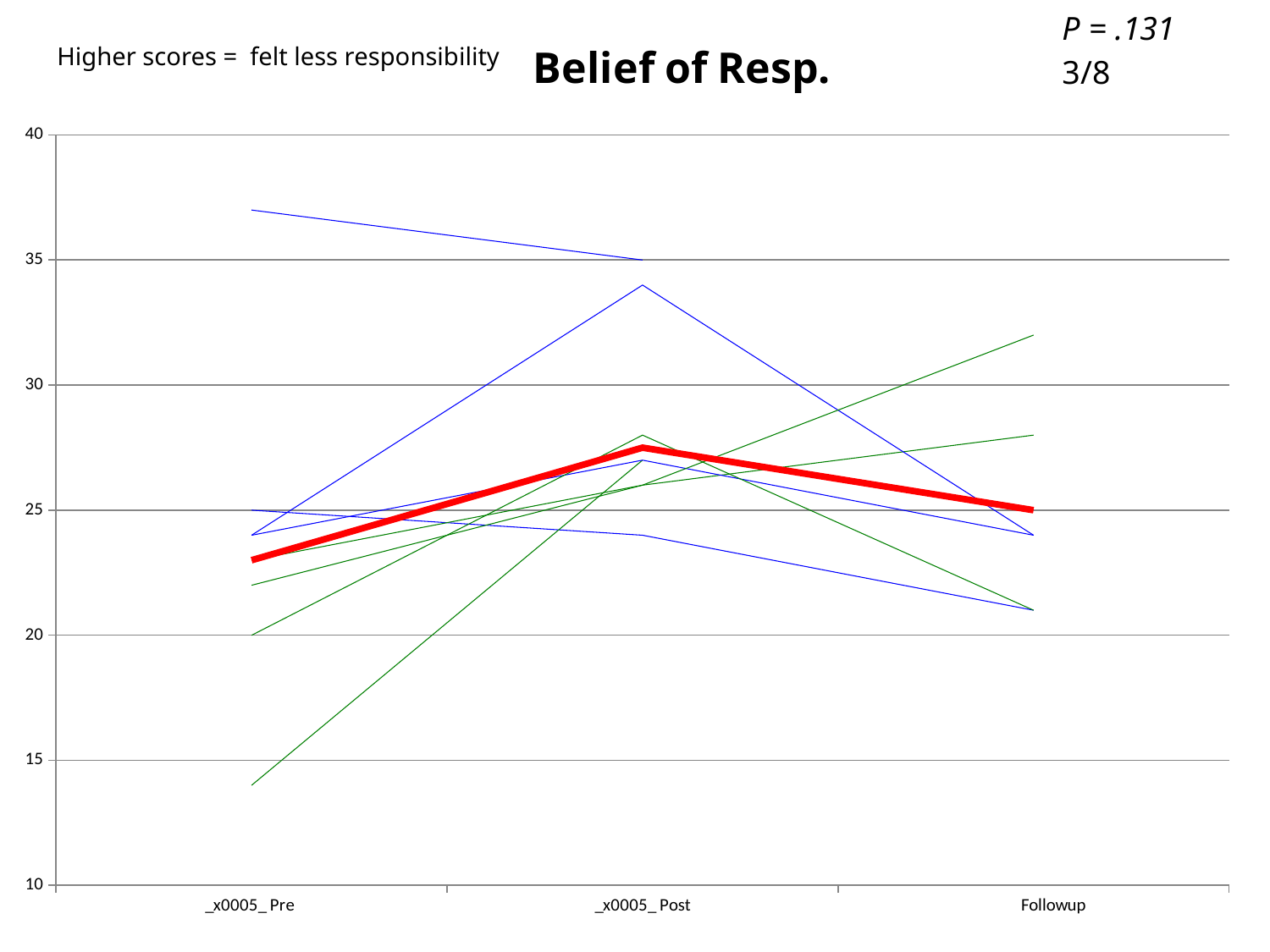
Does the thick red line rise or fall from _x0005_ Pre to _x0005_ Post? rises Does the thick red line rise or fall from _x0005_ Post to Followup? falls What is the title of the chart? Belief of Resp. Is the value of the thick red line at _x0005_ Post greater or less than 25? greater Is the lowest value plotted at _x0005_ Pre greater or less than 15? less What P value is printed on the slide? .131 At which x-axis category does the thick red line reach its highest value? _x0005_ Post Is the highest value plotted at Followup greater or less than 30? greater How many categories are shown on the x axis of the chart? 3 What is the value of the thick red line at Followup? 25 What kind of chart is shown on the slide? line chart